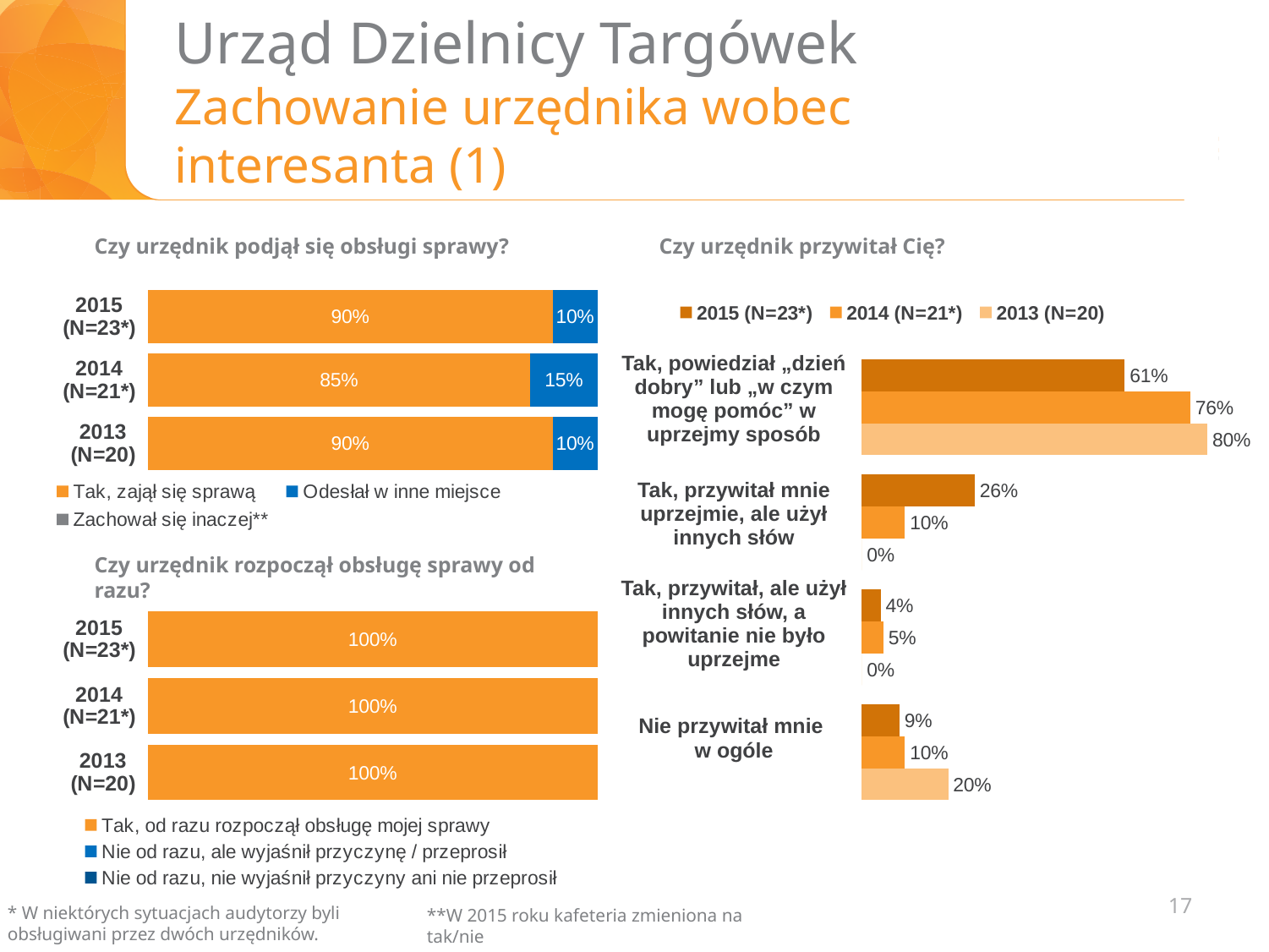
In the chart "Czy urzędnik podjął się obsługi sprawy?", what is the difference between the "Tak, zajął się sprawą" values for 2015 and 2014? 5 percentage points In the chart "Czy urzędnik podjął się obsługi sprawy?", which year has the highest value for "Odesłał w inne miejsce"? 2014 (N=21*) In the chart "Czy urzędnik przywitał Cię?", what is the 2015 (N=23*) value for "Tak, przywitał mnie uprzejmie, ale użył innych słów"? 26% What kind of chart is "Czy urzędnik przywitał Cię?"? Bar chart In the chart "Czy urzędnik podjął się obsługi sprawy?", what percentage is shown for "Tak, zajął się sprawą" in 2014 (N=21*)? 85% In the chart "Czy urzędnik podjął się obsługi sprawy?", what percentage is shown for "Odesłał w inne miejsce" in 2015 (N=23*)? 10% In the chart "Czy urzędnik przywitał Cię?", what is the difference between the 2013 and 2015 values for "Tak, powiedział „dzień dobry” lub „w czym mogę pomóc” w uprzejmy sposób"? 19 percentage points How many legend entries does the chart "Czy urzędnik rozpoczął obsługę sprawy od razu?" list? 3 In the chart "Czy urzędnik przywitał Cię?", which year has the highest value for "Nie przywitał mnie w ogóle"? 2013 (N=20) In the chart "Czy urzędnik rozpoczął obsługę sprawy od razu?", what percentage is shown for 2013 (N=20)? 100% In the chart "Czy urzędnik przywitał Cię?", what is the 2013 (N=20) value for "Tak, powiedział „dzień dobry” lub „w czym mogę pomóc” w uprzejmy sposób"? 80% In the chart "Czy urzędnik przywitał Cię?", is the 2014 (N=21*) value for "Nie przywitał mnie w ogóle" larger or smaller than the 2013 (N=20) value? smaller